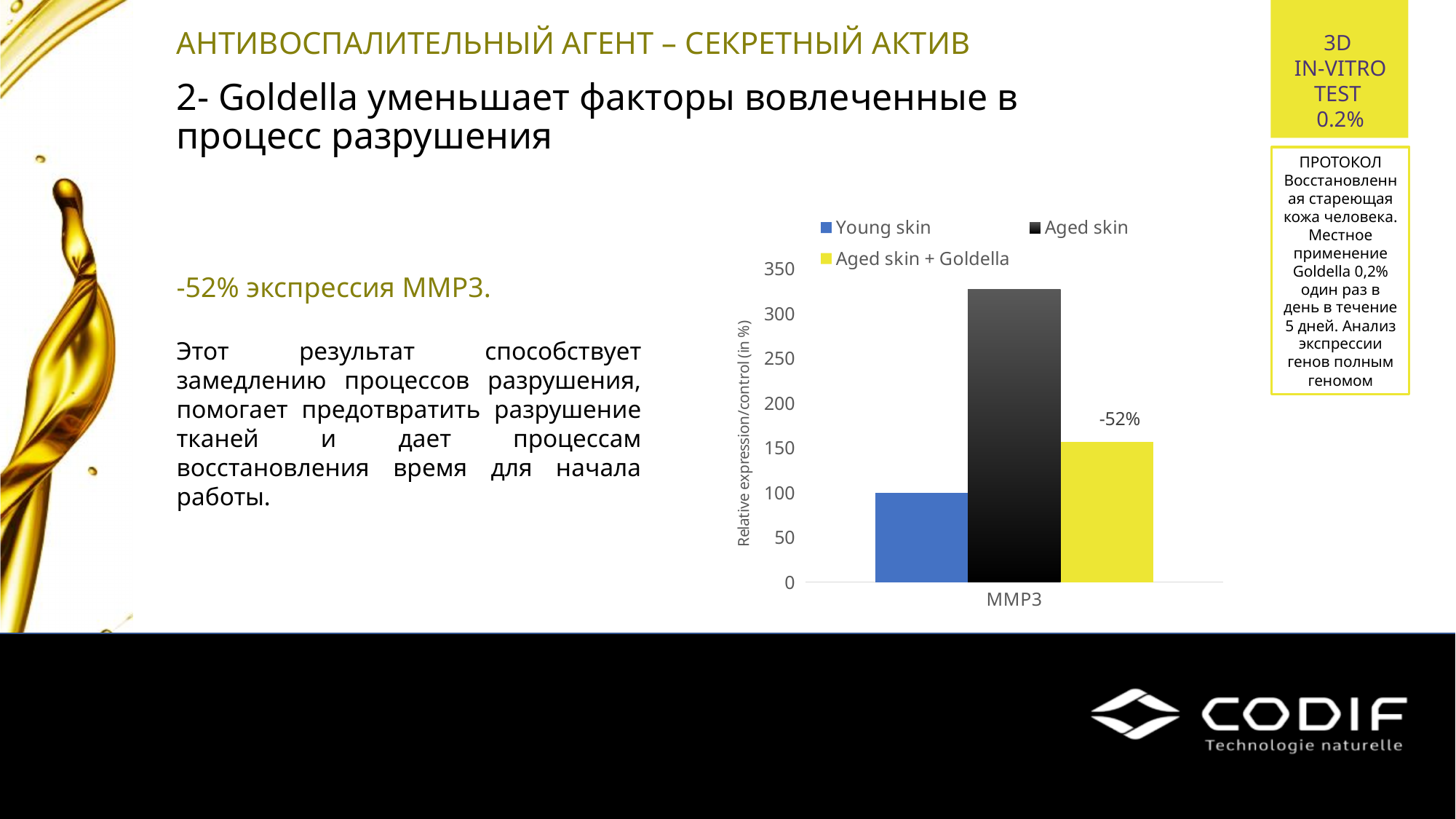
What is the title of the chart's y axis? Relative expression/control (in %) What is the value of the Young skin bar for MMP3? 100 Is the value for Aged skin greater or less than 300? greater What data label is printed above the Aged skin + Goldella bar? -52% Which is larger for MMP3: the Aged skin bar or the Aged skin + Goldella bar? Aged skin What kind of chart is shown on the slide? bar chart How many categories are shown on the x axis of the chart? 1 How many series does the chart legend list? 3 Is the value for Aged skin + Goldella greater or less than 100? greater Is the value for Aged skin + Goldella greater or less than 200? less Which series has the lowest bar for MMP3? Young skin Which series has the highest bar for MMP3? Aged skin